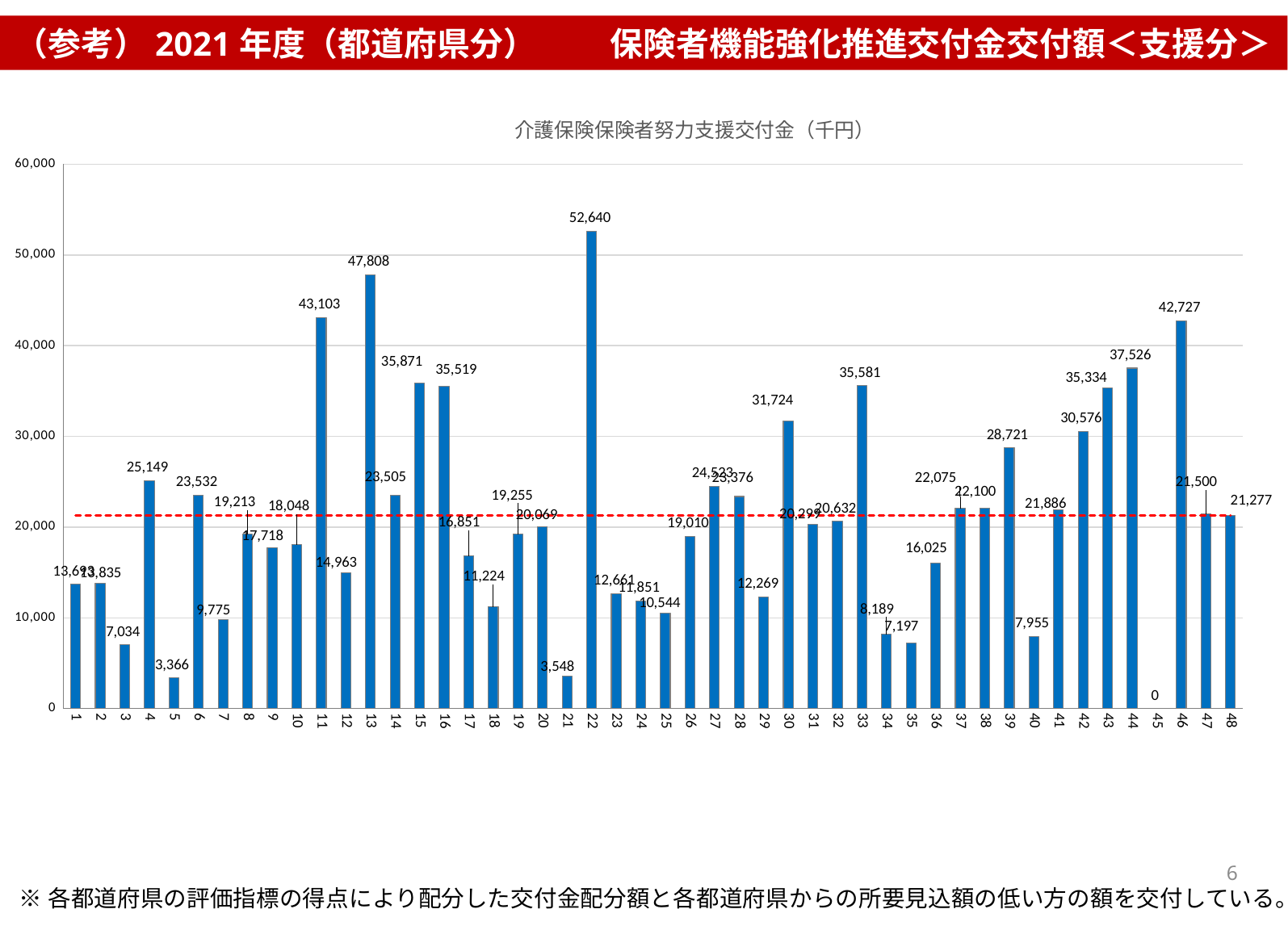
What is the value for category 22? 52,640 What is the value for category 13? 47,808 What is the difference between the values for category 22 and category 13? 4,832 Which category has the lowest value? 45 What is the value for category 5? 3,366 What is the value for category 45? 0 Is the value for category 30 greater or less than 30,000? greater What is the value for category 46? 42,727 What kind of chart is shown on the slide? bar chart Which category has the highest value? 22 Which is larger, the value for category 11 or the value for category 13? 13 How many categories are shown on the x axis? 48